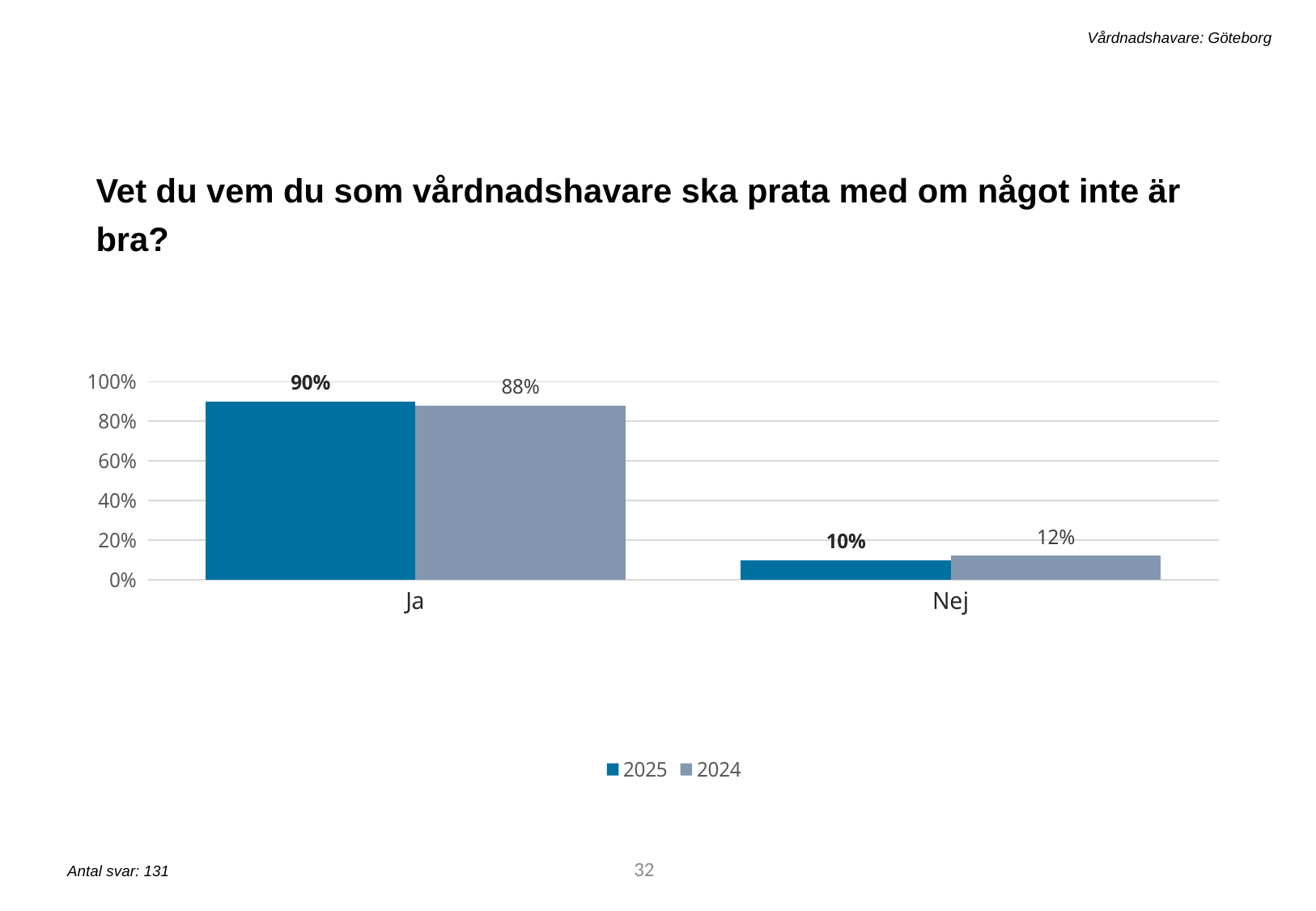
Which is larger for "Nej": the 2025 value or the 2024 value? 2024 What is the value for "Nej" in the 2024 series? 12% What is the value for "Ja" in the 2024 series? 88% Which series is shown in the darker blue colour? 2025 What is the difference between the 2025 and 2024 values for "Ja"? 2 percentage points How many series does the legend list? 2 What is the value for "Nej" in the 2025 series? 10% What is the value for "Ja" in the 2025 series? 90% Which category has the lowest value in the 2024 series? Nej Which category has the highest value in the 2025 series? Ja How many categories are shown on the x axis? 2 What kind of chart is shown on the slide? Bar chart